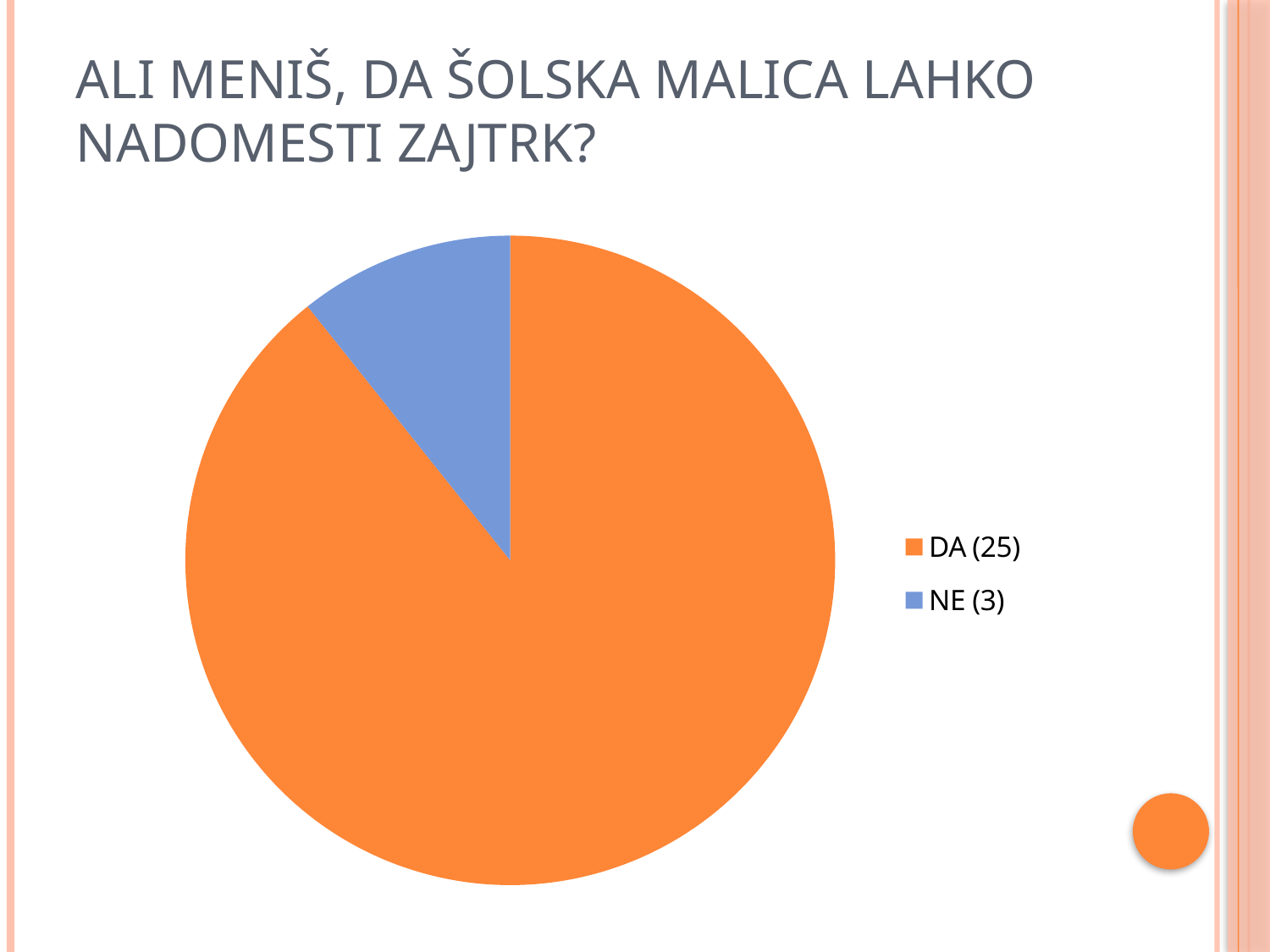
What is the difference between the number of DA responses and NE responses? 22 How many responses does the DA slice represent? 25 What colour is the NE slice? Blue Which is larger, the DA slice or the NE slice? DA What colour is the DA slice? Orange How many entries does the legend list? 2 How many slices does the pie chart have? 2 How many responses does the NE slice represent? 3 What kind of chart is shown on the slide? Pie chart What is the total number of responses shown in the pie chart? 28 Which category has the largest slice of the pie? DA Which category has the smallest slice of the pie? NE